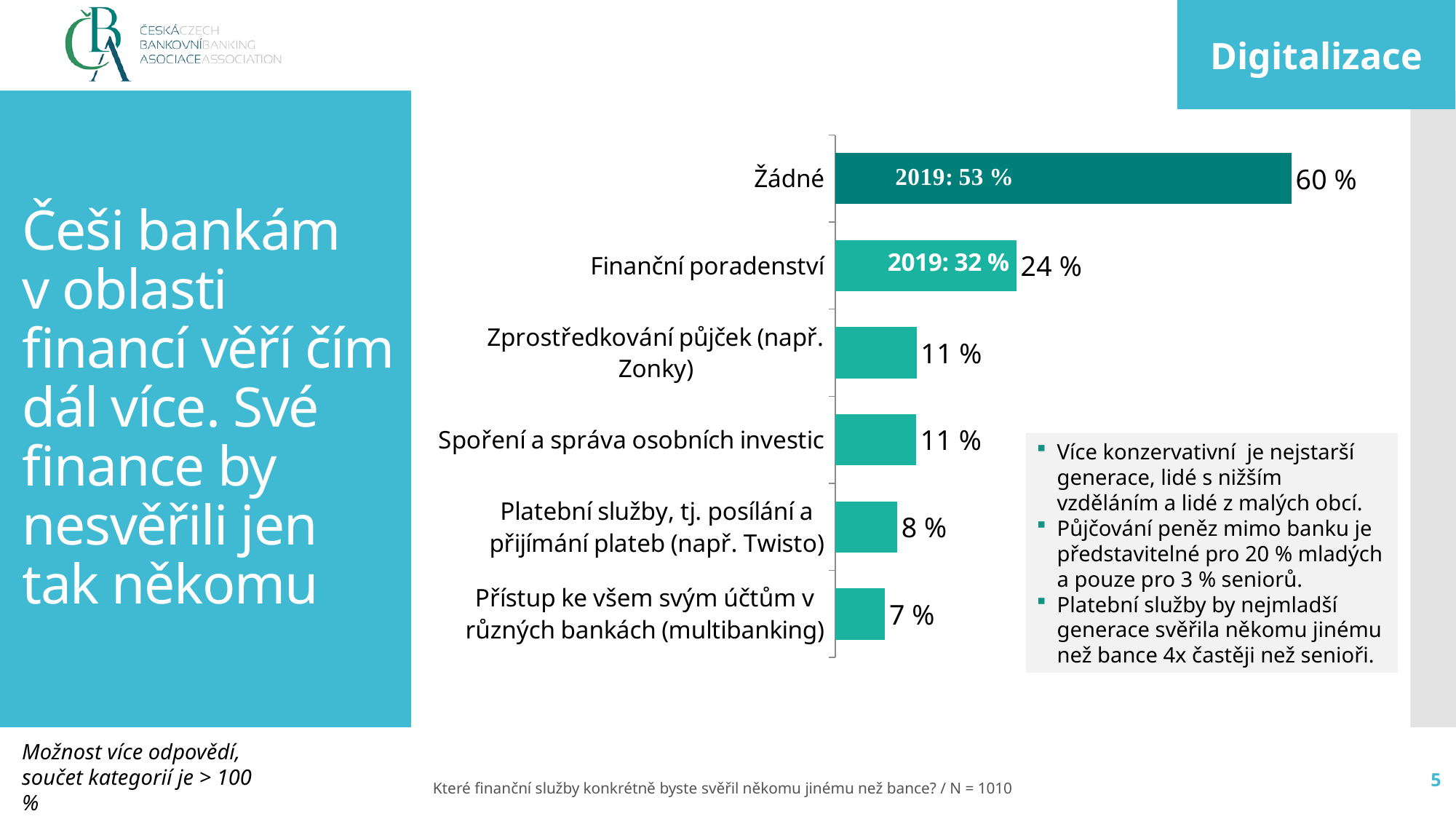
Which category has the highest value? Žádné What kind of chart is shown on the slide? Bar chart What was the 2019 value shown for "Finanční poradenství"? 32 % How many categories are shown in the chart? 6 What is the value for "Finanční poradenství"? 24 % Which is larger: the value for "Zprostředkování půjček (např. Zonky)" or for "Platební služby, tj. posílání a přijímání plateb (např. Twisto)"? Zprostředkování půjček (např. Zonky) Which category has the lowest value? Přístup ke všem svým účtům v různých bankách (multibanking) What is the difference between the values for "Žádné" and "Finanční poradenství"? 36 % What is the value for "Žádné"? 60 % What is the value for "Přístup ke všem svým účtům v různých bankách (multibanking)"? 7 % What is the value for "Platební služby, tj. posílání a přijímání plateb (např. Twisto)"? 8 % By how much did the value for "Žádné" change from 2019 (53 %) to the current value (60 %)? 7 %